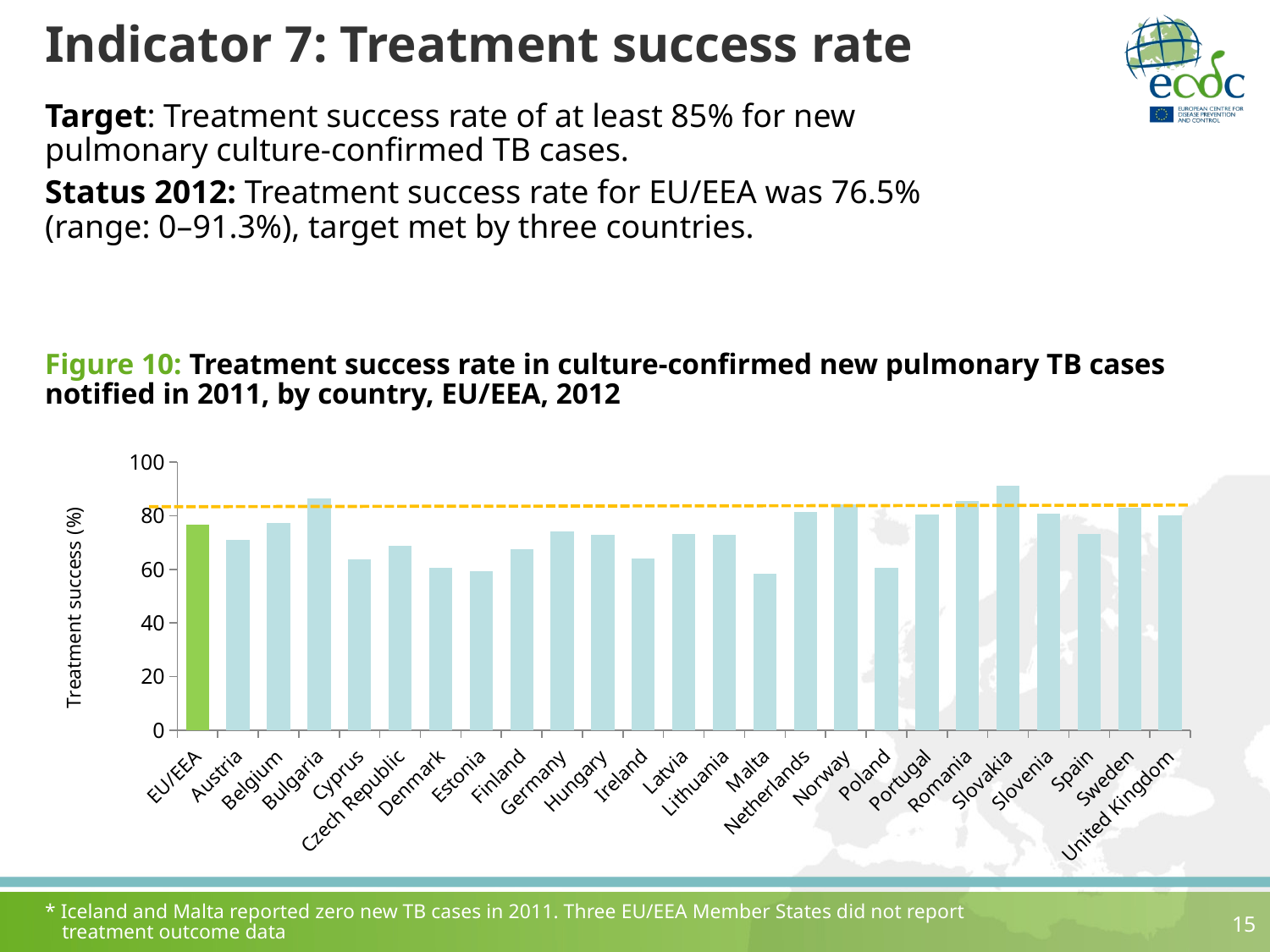
Which bar in the chart is coloured green rather than light blue? EU/EEA Which has a higher treatment success rate, Bulgaria or Austria? Bulgaria How many countries/categories are shown on the x axis of the chart? 25 Is the value for Norway greater or less than 80? greater Is the value for Bulgaria greater or less than 80? greater What is the treatment success rate for EU/EEA shown on the slide? 76.5% Which country has the highest treatment success rate in the chart? Slovakia Is the value for Malta greater or less than 60? less What kind of chart is shown in Figure 10? bar chart What is the label on the y axis of the chart? Treatment success (%) Which has a higher treatment success rate, Germany or Finland? Germany